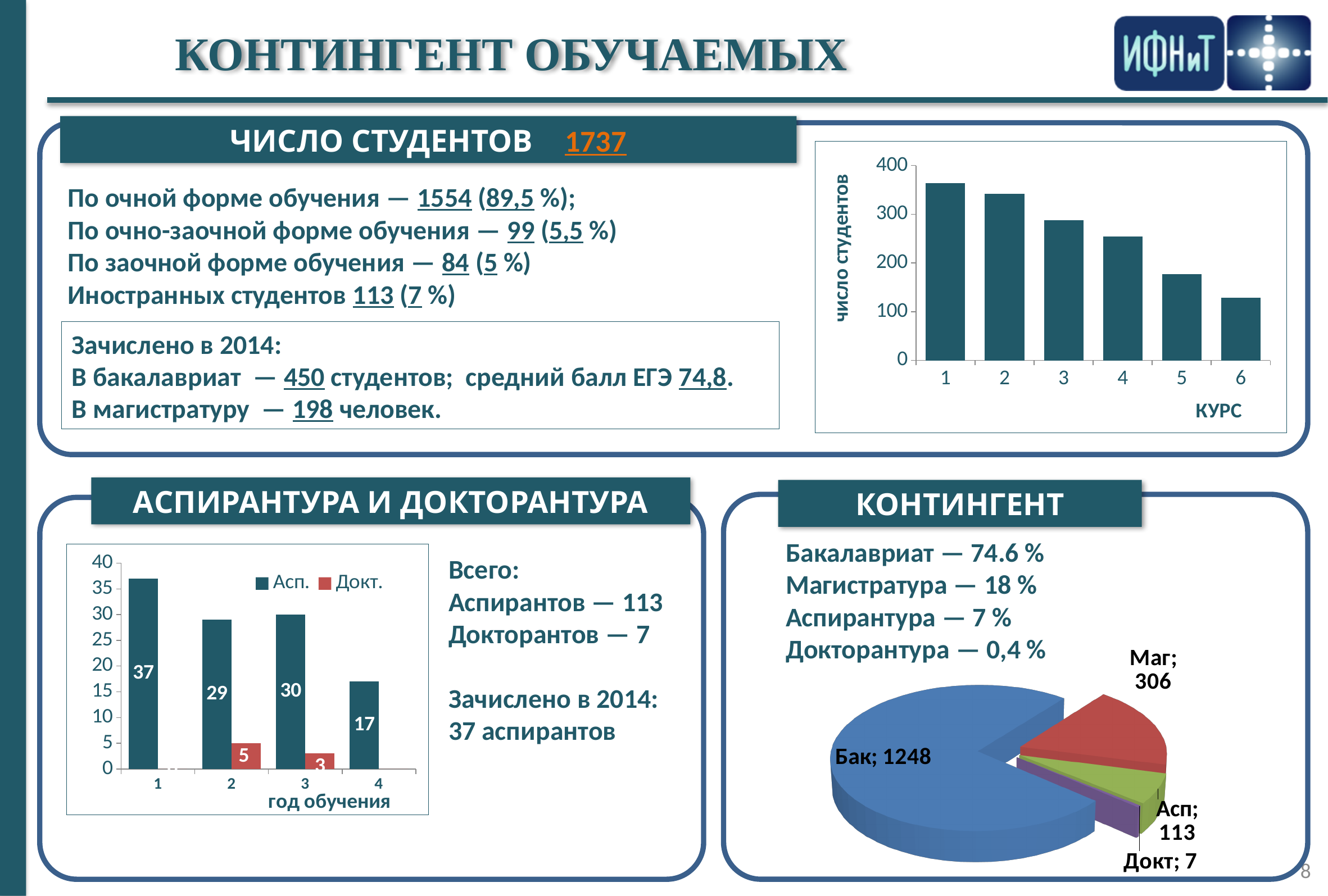
In the bottom-right pie chart (Контингент), what is the value for Маг? 306 In the top-right bar chart of число студентов by курс, which курс has the lowest number of students? 6 In the bottom-left bar chart (Аспирантура и докторантура), what is the value for Асп. in год обучения 2? 29 In the top-right bar chart of число студентов by курс, do the values rise or fall as курс increases from 1 to 6? fall In the top-right bar chart of число студентов by курс, is the value for курс 6 greater or less than 200? less In the top-right bar chart of число студентов by курс, which курс has the highest number of students? 1 In the bottom-left bar chart (Аспирантура и докторантура), what is the value for Докт. in год обучения 3? 3 In the top-right bar chart of число студентов by курс, is the value for курс 1 greater or less than 300? greater In the top-right bar chart of число студентов by курс, how many курс categories are shown? 6 What kind of chart is shown in the bottom-right Контингент panel? pie chart In the bottom-left bar chart (Аспирантура и докторантура), how many series does the legend list? 2 In the bottom-left bar chart (Аспирантура и докторантура), what is the difference between the Асп. values for год обучения 1 and год обучения 4? 20